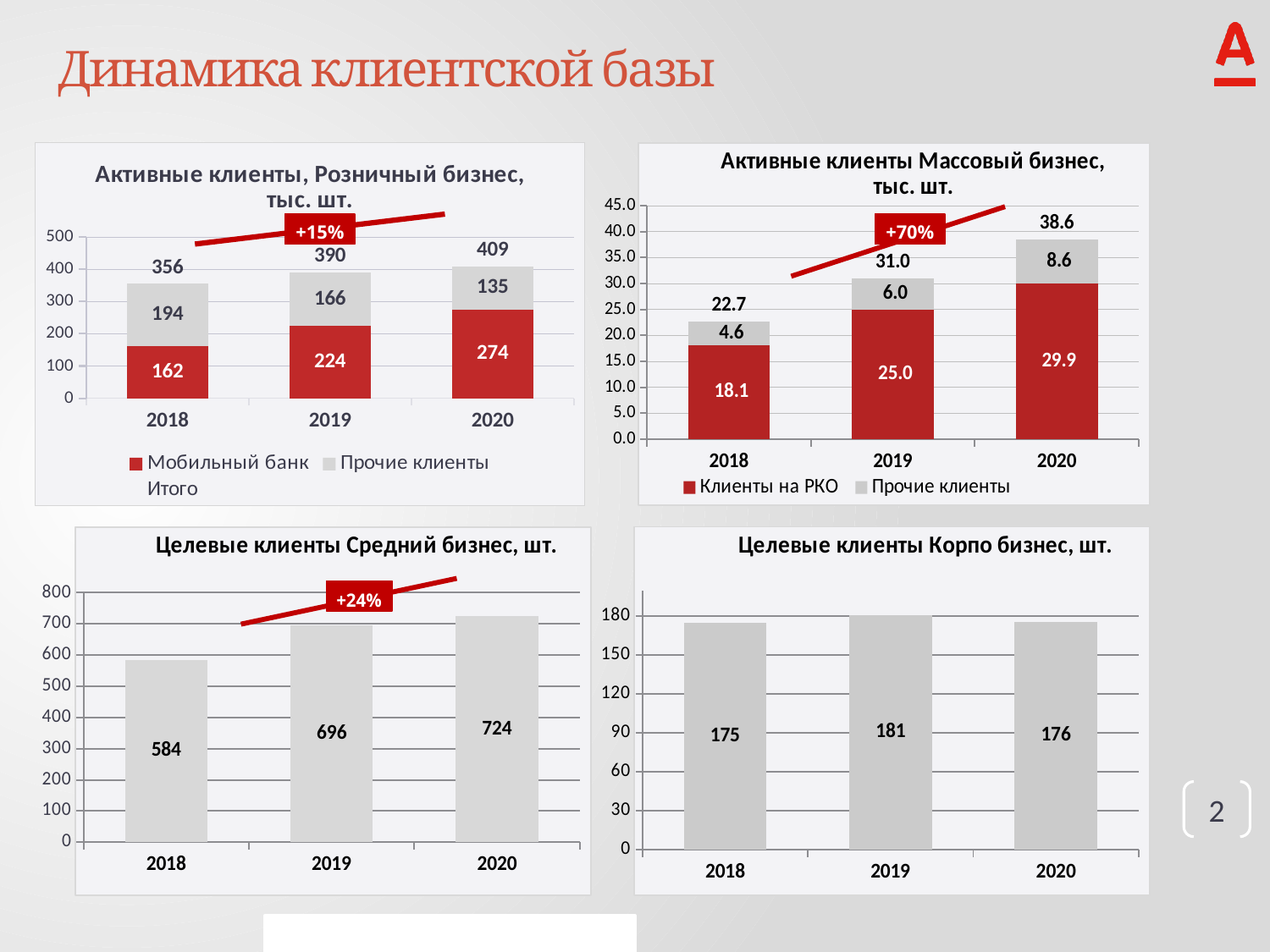
In the chart 'Активные клиенты Массовый бизнес, тыс. шт.', which year has the highest total? 2020 In the chart 'Целевые клиенты Средний бизнес, шт.', what is the value for 2018? 584 In the chart 'Активные клиенты, Розничный бизнес, тыс. шт.', what is the value for Мобильный банк in 2020? 274 In the chart 'Целевые клиенты Корпо бизнес, шт.', which year has the highest value? 2019 In the chart 'Активные клиенты Массовый бизнес, тыс. шт.', what is the value for Клиенты на РКО in 2019? 25.0 In the chart 'Целевые клиенты Корпо бизнес, шт.', what is the difference between the values for 2019 and 2018? 6 How many years are shown on the x axis of the chart 'Целевые клиенты Корпо бизнес, шт.'? 3 What kind of chart is 'Целевые клиенты Средний бизнес, шт.'? bar chart In the chart 'Активные клиенты, Розничный бизнес, тыс. шт.', what is the difference between the Мобильный банк values for 2020 and 2018? 112 In the chart 'Активные клиенты Массовый бизнес, тыс. шт.', how many series does the legend list? 2 In the chart 'Целевые клиенты Средний бизнес, шт.', do the values rise or fall from 2018 to 2020? rise In the chart 'Активные клиенты, Розничный бизнес, тыс. шт.', what is the total of the stacked bar for 2019? 390